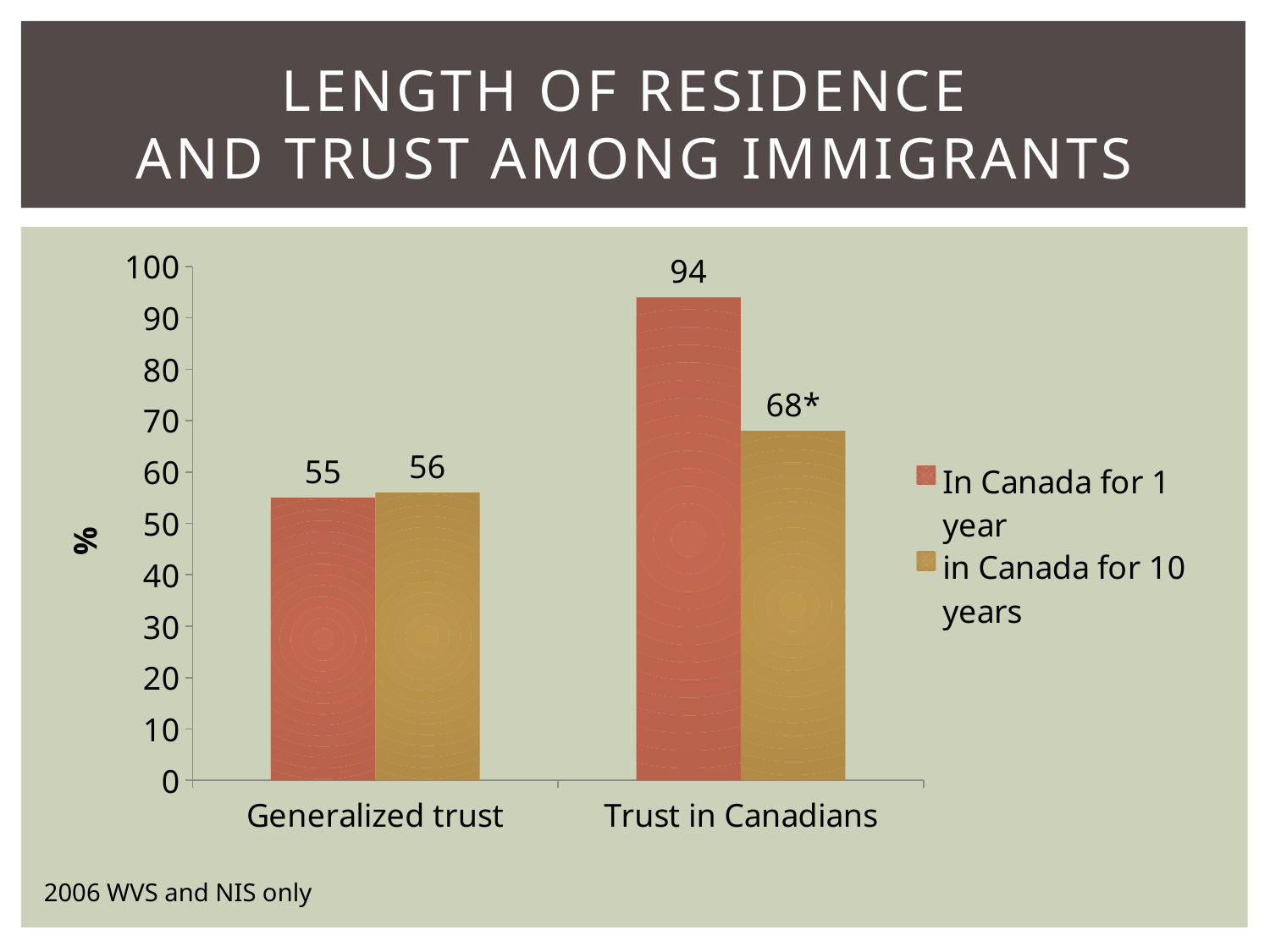
What is the difference between the 'In Canada for 1 year' and 'in Canada for 10 years' values for Trust in Canadians? 26 How many series does the legend list? 2 Is the value for Trust in Canadians for immigrants in Canada for 1 year greater or less than 90? greater What is the value for Trust in Canadians for immigrants in Canada for 10 years? 68* How many categories are shown on the x axis? 2 What is the value for Generalized trust for immigrants in Canada for 10 years? 56 What kind of chart is shown on the slide? bar chart What is the value for Generalized trust for immigrants in Canada for 1 year? 55 What is the value for Trust in Canadians for immigrants in Canada for 1 year? 94 For Trust in Canadians, which is larger: the value for 1 year or for 10 years in Canada? In Canada for 1 year Which category has the highest value for the 'In Canada for 1 year' series? Trust in Canadians What is the label of the y axis? %